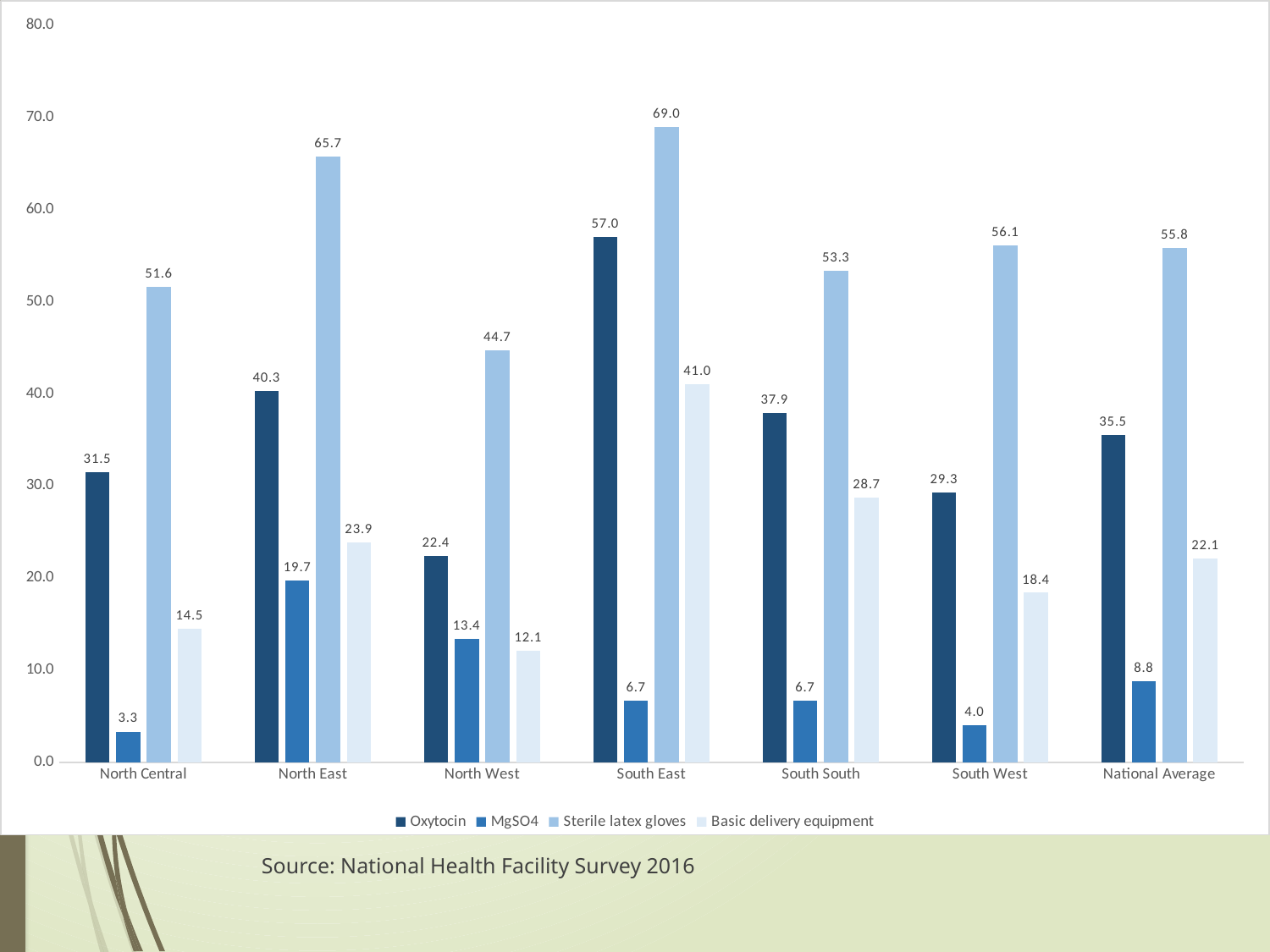
How many series does the legend list? 4 What kind of chart is shown on the slide? Bar chart What is the value for Oxytocin in South East? 57.0 What is the value for MgSO4 in North East? 19.7 Which is larger, the Oxytocin value for North East or for South South? North East What source is cited below the chart? National Health Facility Survey 2016 What is the value for Sterile latex gloves for the National Average? 55.8 Which region has the highest value for Sterile latex gloves? South East What is the difference between the Sterile latex gloves values for North East and North Central? 14.1 How many categories are shown on the x axis? 7 Which region has the lowest value for MgSO4? North Central What is the value for Basic delivery equipment in North West? 12.1